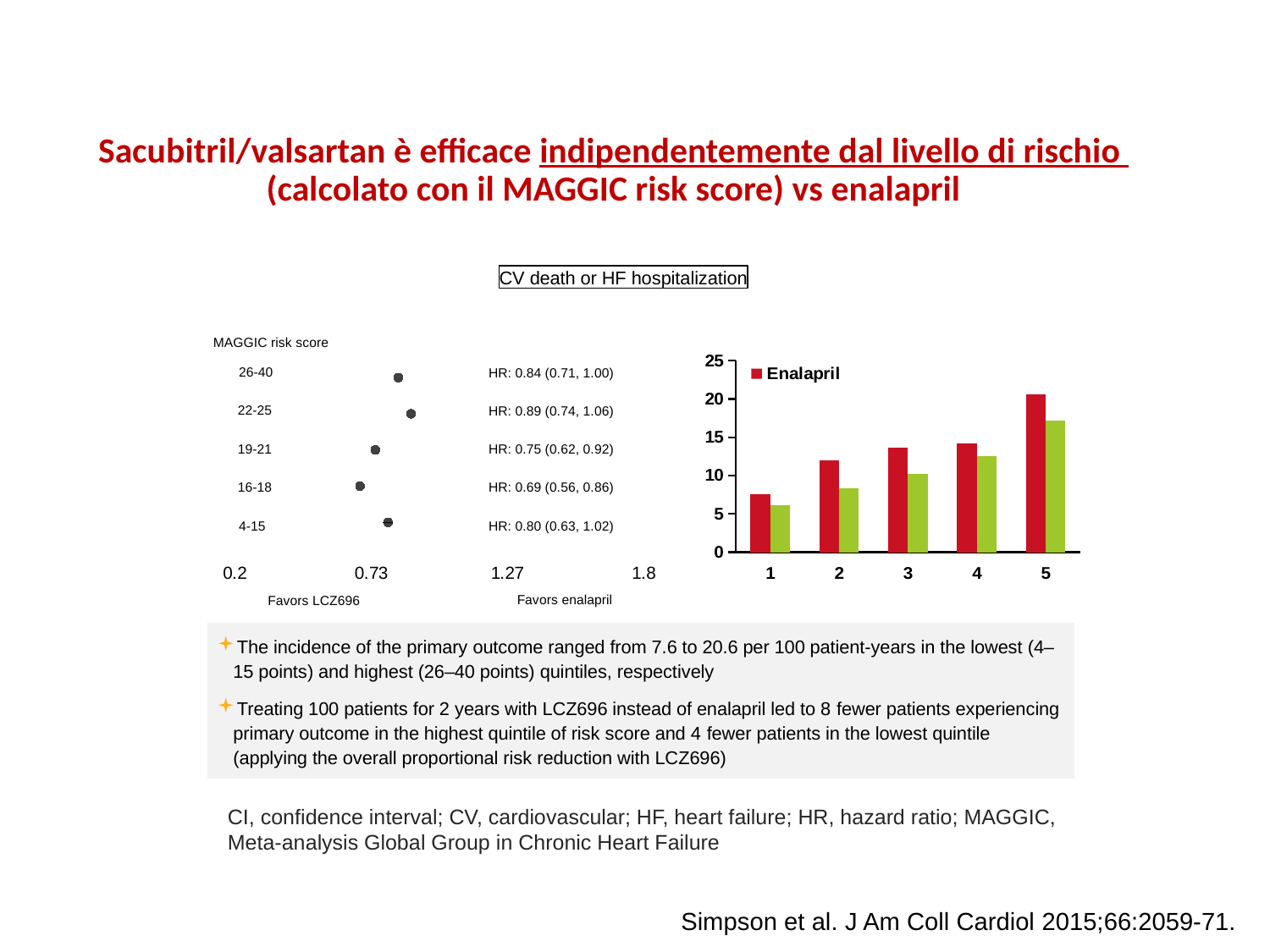
In the forest plot on the left, how many MAGGIC risk score groups are plotted? 5 In the bar chart on the right, is the red bar for category 5 greater or less than 20? greater In the bar chart on the right, how many categories are shown on the x axis? 5 In the forest plot on the left, what is the hazard ratio for the MAGGIC risk score group 16-18? 0.69 In the bar chart on the right, do the red bars rise or fall from category 1 to category 5? rise In the bar chart on the right, is the green bar for category 1 greater or less than 10? less In the forest plot on the left, what is the difference between the hazard ratio for 22-25 and the hazard ratio for 16-18? 0.20 In the forest plot on the left, what is the hazard ratio for the MAGGIC risk score group 26-40? 0.84 In the forest plot on the left, which MAGGIC risk score group has the lowest hazard ratio? 16-18 In the forest plot on the left, which MAGGIC risk score group has the highest hazard ratio? 22-25 In the forest plot on the left, what is the confidence interval shown for the 19-21 risk score group? (0.62, 0.92) What kind of chart is the chart on the right? bar chart